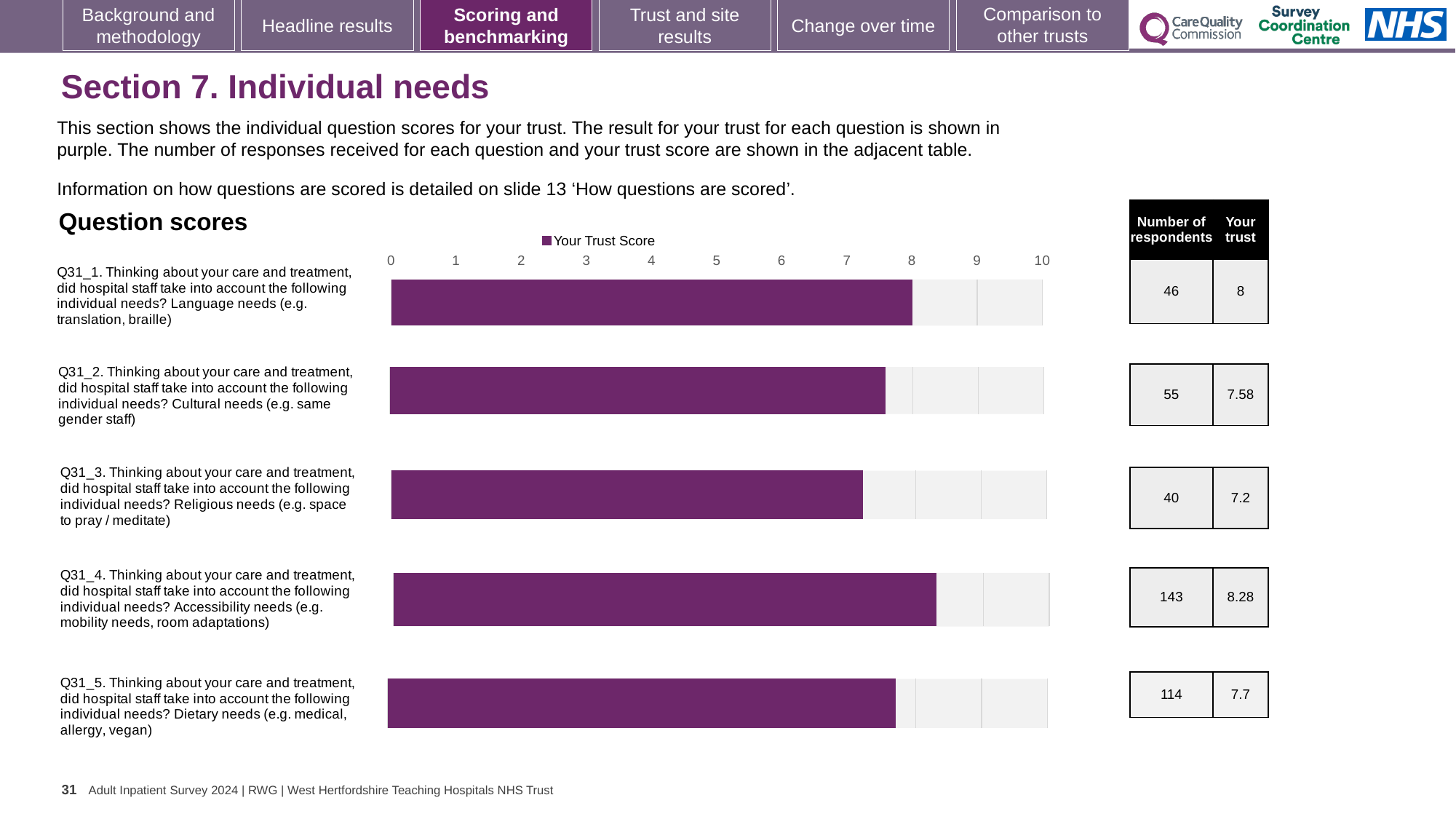
Is the trust score for Q31_2 (Cultural needs) greater or less than 8? less What is the trust score for Q31_4 (Accessibility needs)? 8.28 What is the difference between the trust scores for Q31_4 (Accessibility needs) and Q31_3 (Religious needs)? 1.08 What is the trust score for Q31_3 (Religious needs)? 7.2 What is the trust score for Q31_1 (Language needs)? 8 Which question has the lowest trust score? Q31_3 (Religious needs) Which has the larger trust score, Q31_2 (Cultural needs) or Q31_5 (Dietary needs)? Q31_5 (Dietary needs) What type of chart is used to show the question scores? bar chart Which question has the highest trust score? Q31_4 (Accessibility needs) How many question bars are shown on the slide? 5 What series does the chart legend list? Your Trust Score How many respondents answered Q31_5 (Dietary needs)? 114